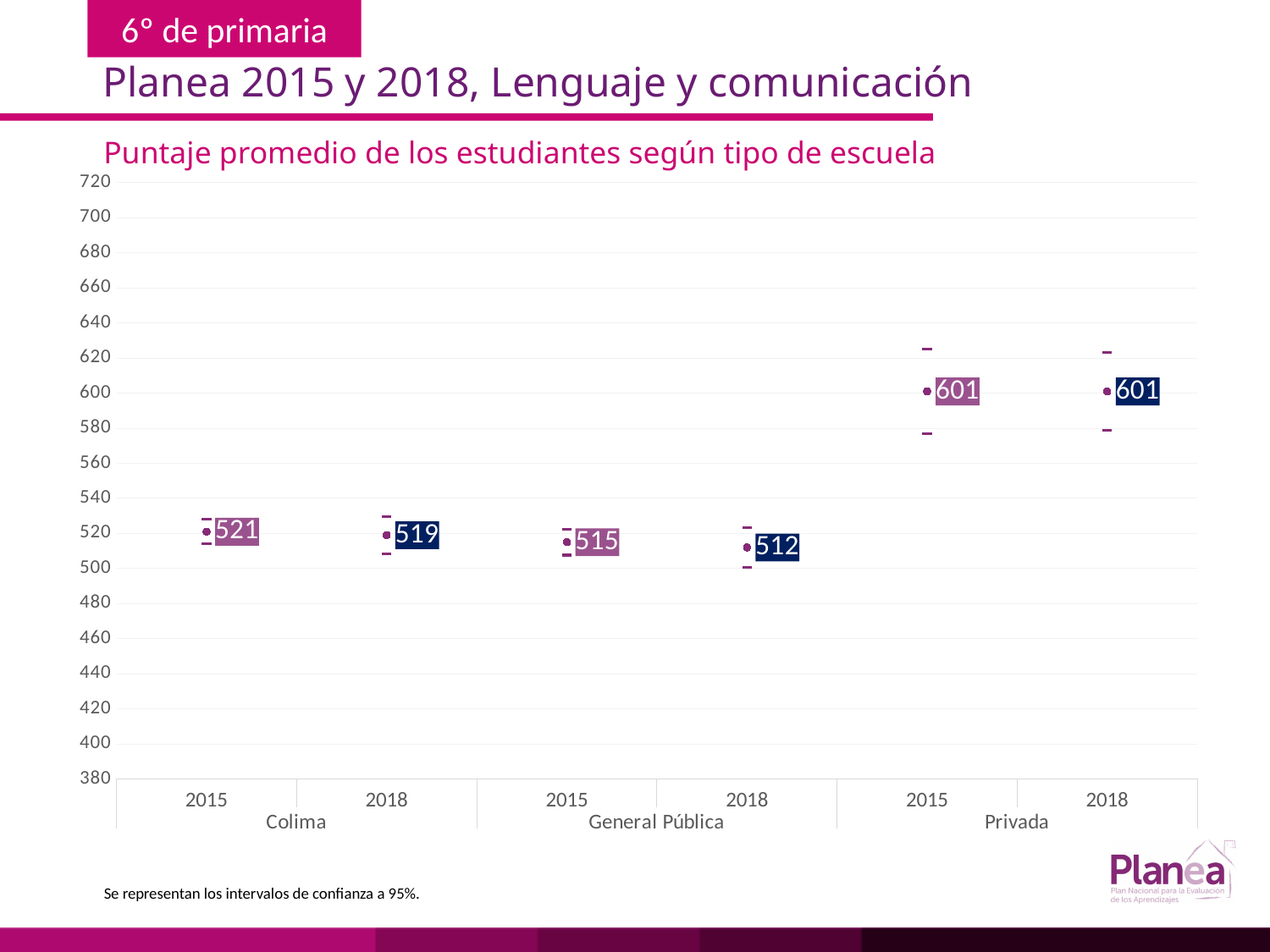
Which school type has the lowest average score in 2015? General Pública What is the title of the chart? Puntaje promedio de los estudiantes según tipo de escuela What is the average score for General Pública schools in 2018? 512 By how much did the Colima score change from 2015 to 2018? 2 How many data points are plotted on the chart? 6 What is the average score for Colima in 2018? 519 What is the difference between the Privada score and the General Pública score in 2018? 89 What is the average score for Privada schools in 2015? 601 Which school type has the highest average score in 2018? Privada What is the average score for Colima in 2015? 521 Which is larger, the Colima score in 2015 or the General Pública score in 2015? Colima 2015 Did the General Pública score rise or fall from 2015 to 2018? fall